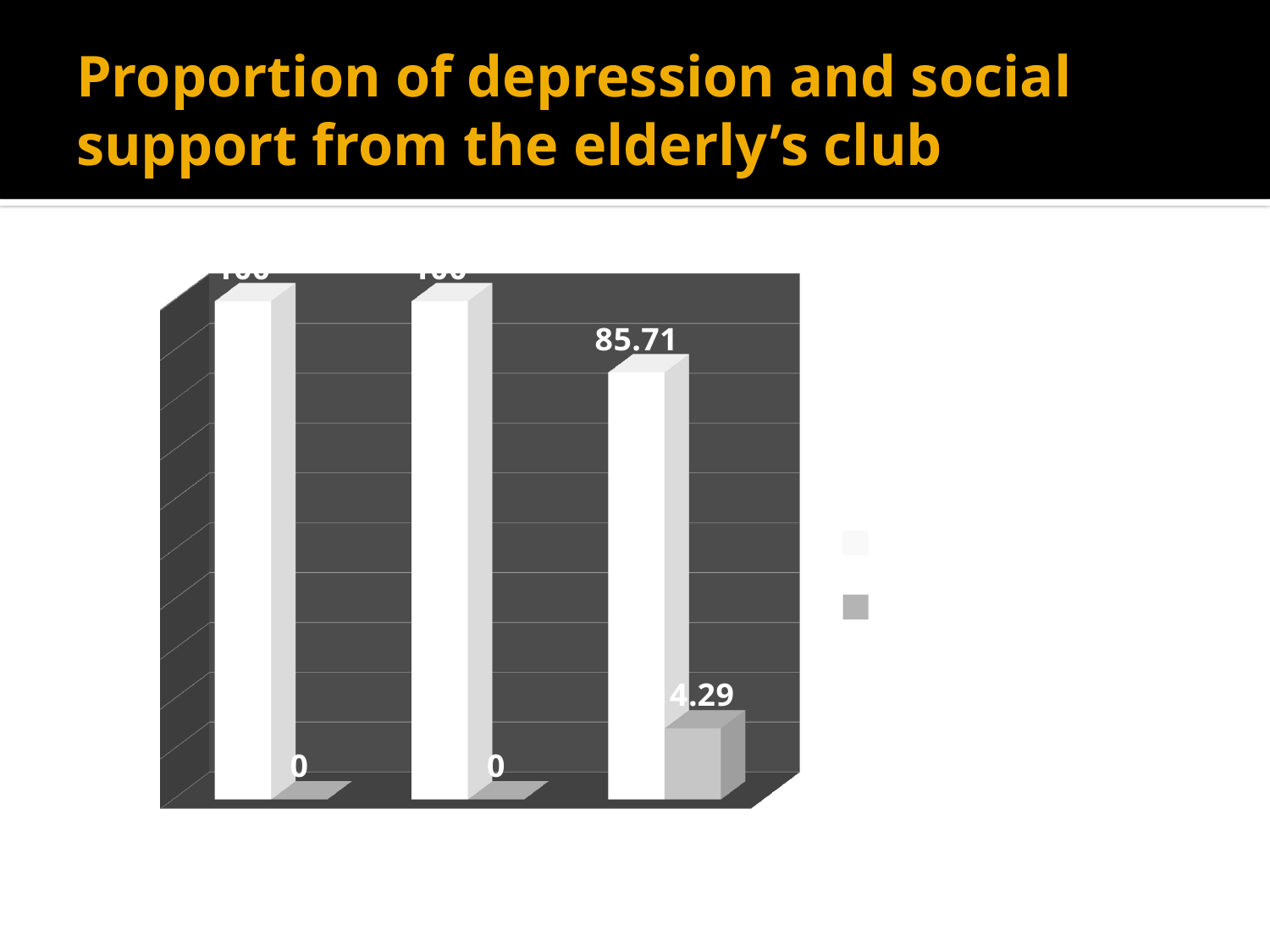
How many groups of bars are plotted in the chart? 3 In the rightmost group, what is the difference between the white bar and the gray bar? 71.42 What kind of chart is shown on the slide? bar chart What is the value of the gray bar in the rightmost group? 14.29 What is the value of the white bar in the rightmost group? 85.71 Which group has the shortest white bar? the rightmost group Which group has the tallest gray bar? the rightmost group In the rightmost group, which bar is larger, the white one or the gray one? the white one What two colours are used for the two series in the chart? white and gray How many series does the legend list? 2 What is the value of the gray bar in the middle group? 0 What is the value of the gray bar in the leftmost group? 0